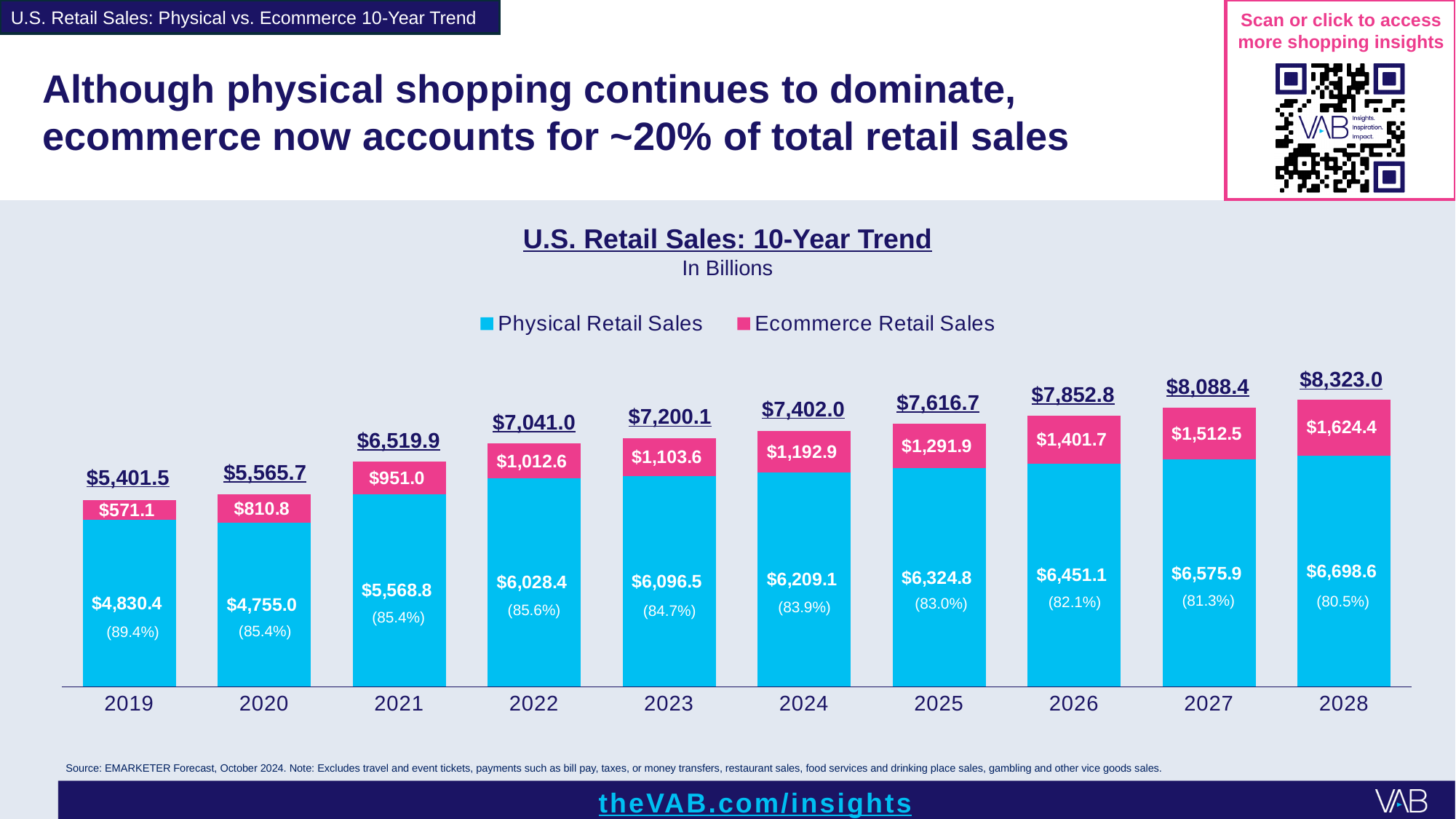
Which year has the lowest Physical Retail Sales value? 2020 What percentage share of total retail sales does Physical Retail Sales account for in 2028? 80.5% What is the Ecommerce Retail Sales value for 2024? $1,192.9 How many series does the legend list? 2 How many years are shown on the x axis? 10 What is the difference between the Ecommerce Retail Sales values for 2028 and 2019? $1,053.3 Which is larger, the Physical Retail Sales value for 2021 or for 2020? 2021 Do the total retail sales values rise or fall from 2019 to 2028? Rise What is the total retail sales value shown above the bar for 2022? $7,041.0 What is the Physical Retail Sales value for 2019? $4,830.4 Which year has the highest Ecommerce Retail Sales value? 2028 What kind of chart is shown? Stacked bar chart